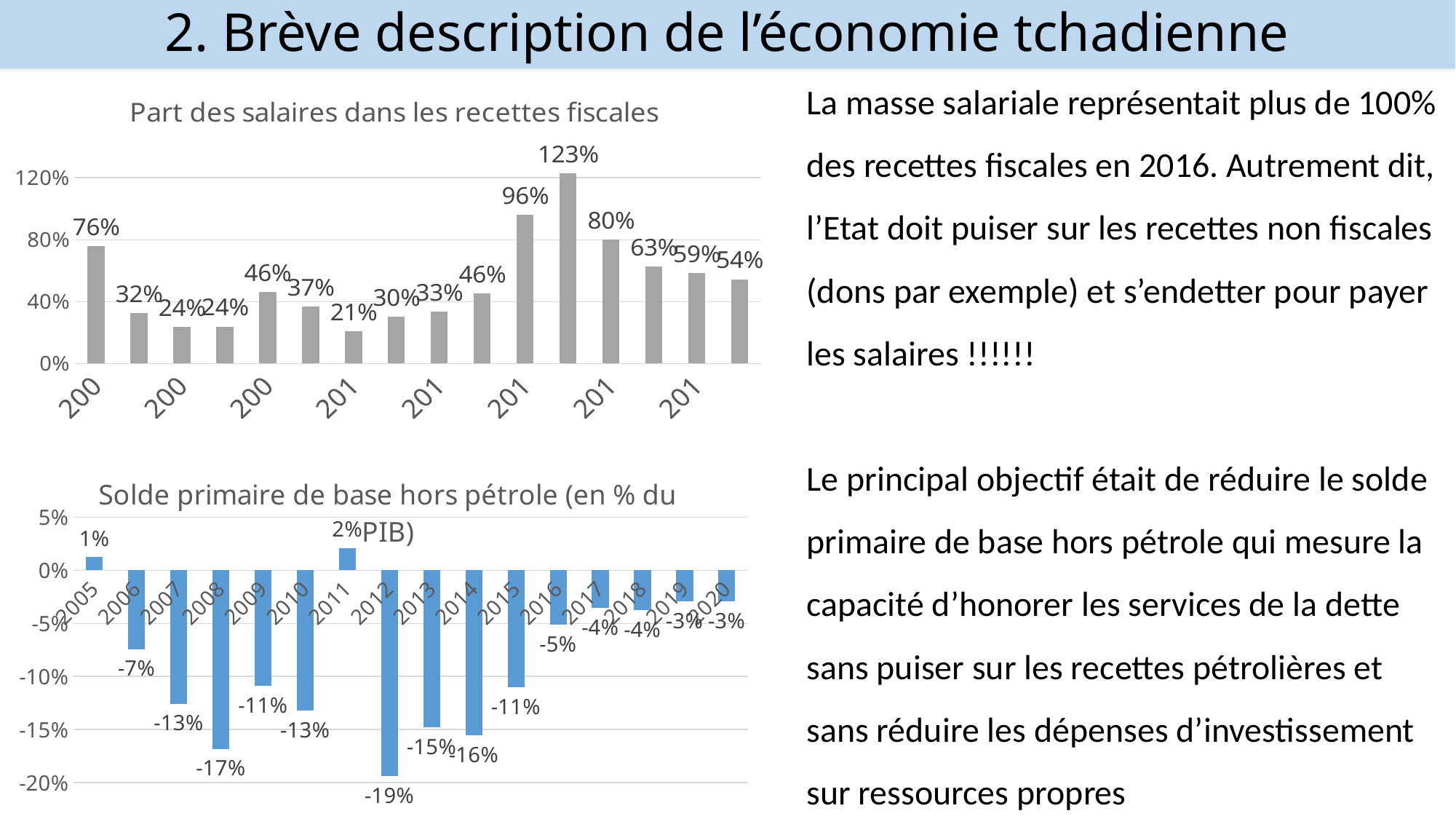
In the chart 'Part des salaires dans les recettes fiscales', what is the lowest value shown? 21% In the chart 'Solde primaire de base hors pétrole (en % du PIB)', what is the value for 2011? 2% In the chart 'Solde primaire de base hors pétrole (en % du PIB)', which year has the highest value? 2011 In the chart 'Solde primaire de base hors pétrole (en % du PIB)', which year has the lowest value? 2012 In the chart 'Part des salaires dans les recettes fiscales', what is the highest value shown? 123% How many bars are plotted in the chart 'Part des salaires dans les recettes fiscales'? 16 In the chart 'Solde primaire de base hors pétrole (en % du PIB)', what is the difference between the values for 2007 and 2008? 4 percentage points What kind of chart is 'Part des salaires dans les recettes fiscales'? Bar chart In the chart 'Solde primaire de base hors pétrole (en % du PIB)', what is the value for 2012? -19% In the chart 'Solde primaire de base hors pétrole (en % du PIB)', what is the value for 2008? -17% In the chart 'Solde primaire de base hors pétrole (en % du PIB)', which year has the larger value, 2006 or 2016? 2016 In the chart 'Part des salaires dans les recettes fiscales', is the tallest bar greater or less than 120%? greater